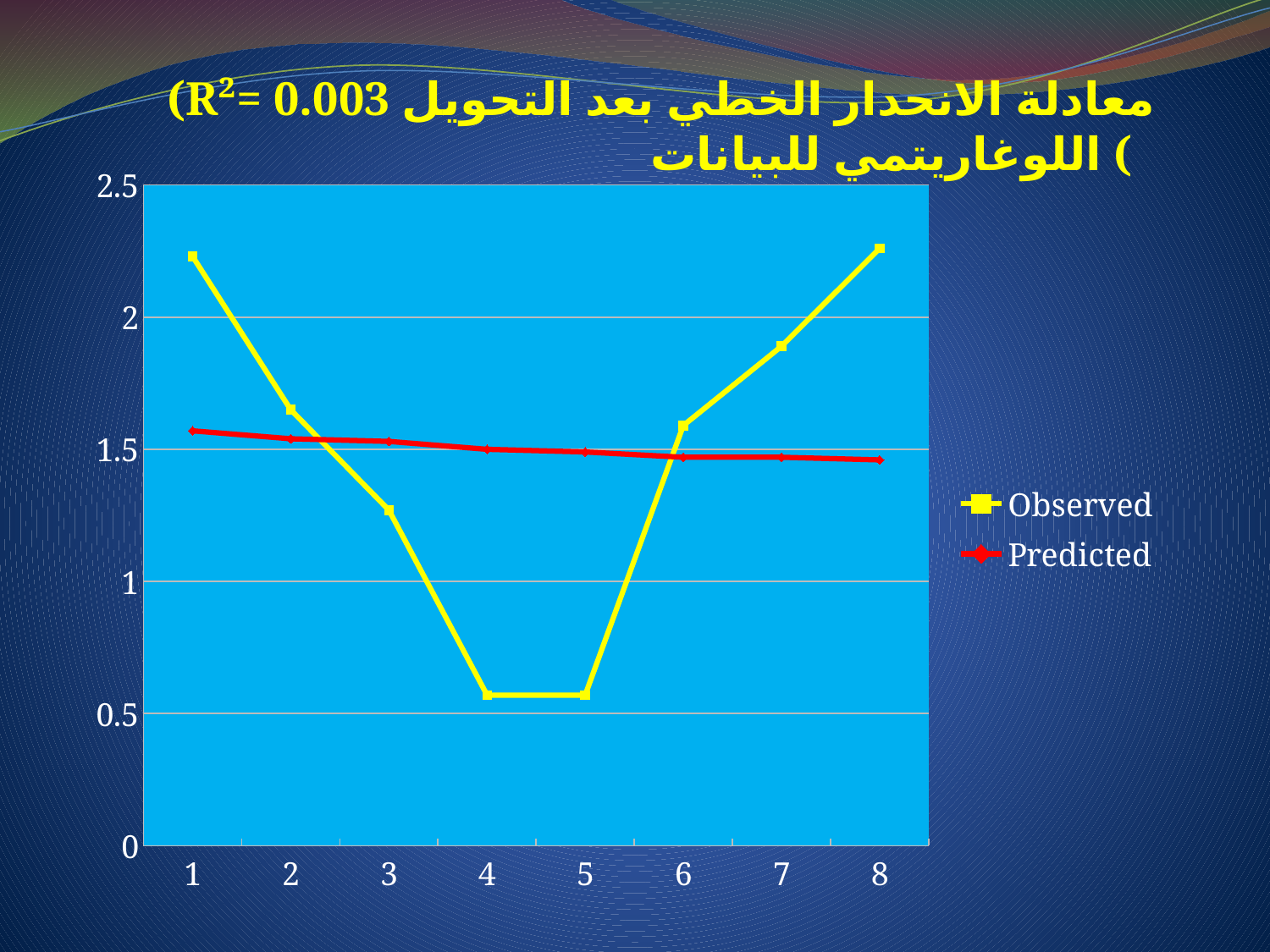
Is the Observed value at x = 4 greater or less than 1? less What kind of chart is shown on the slide? line chart How many points are plotted along the x axis for each series? 8 What colour is the Observed line? yellow At x = 4, which series has the larger value, Observed or Predicted? Predicted Is the Predicted value at x = 1 greater or less than 1.5? greater Does the Predicted series rise or fall as x increases from 1 to 8? falls At x = 8, which series has the larger value, Observed or Predicted? Observed Is the Observed value at x = 3 greater or less than 1? greater How many series does the legend list? 2